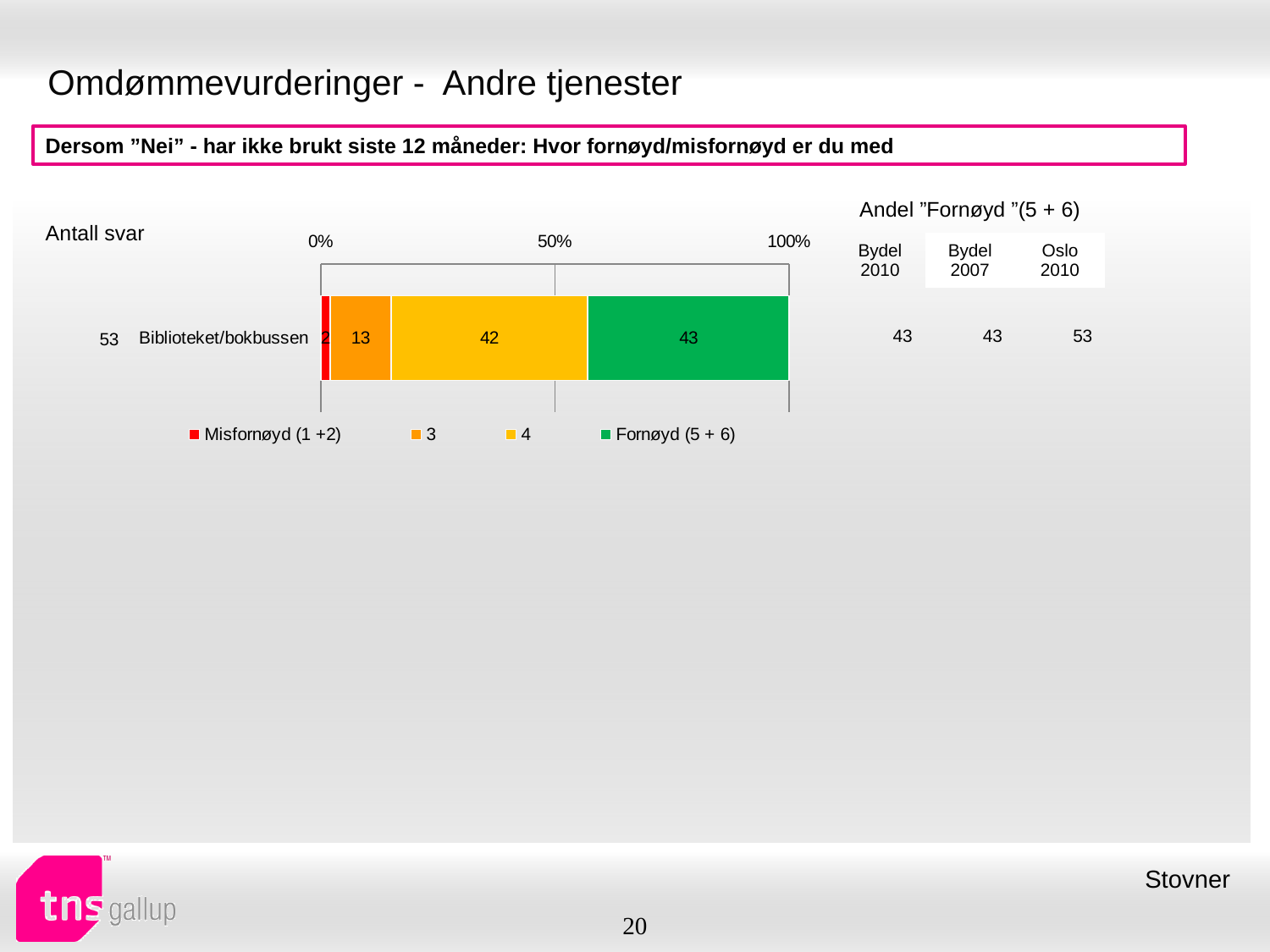
Which segment of the Biblioteket/bokbussen bar has the largest value? Fornøyd (5 + 6) How many categories are plotted in the chart? 1 How many series does the chart legend list? 4 Which segment of the Biblioteket/bokbussen bar has the smallest value? Misfornøyd (1 +2) What is the difference between the "4" segment and the "3" segment for Biblioteket/bokbussen? 29 What is the total of all segments in the Biblioteket/bokbussen bar? 100 What is the value of the "4" segment for Biblioteket/bokbussen? 42 What is the value of the "Fornøyd (5 + 6)" segment for Biblioteket/bokbussen? 43 What colour is the "Fornøyd (5 + 6)" segment in the chart? Green What kind of chart is shown on the slide? Stacked bar chart What is the value of the "Misfornøyd (1 +2)" segment for Biblioteket/bokbussen? 2 What is the value of the "3" segment for Biblioteket/bokbussen? 13